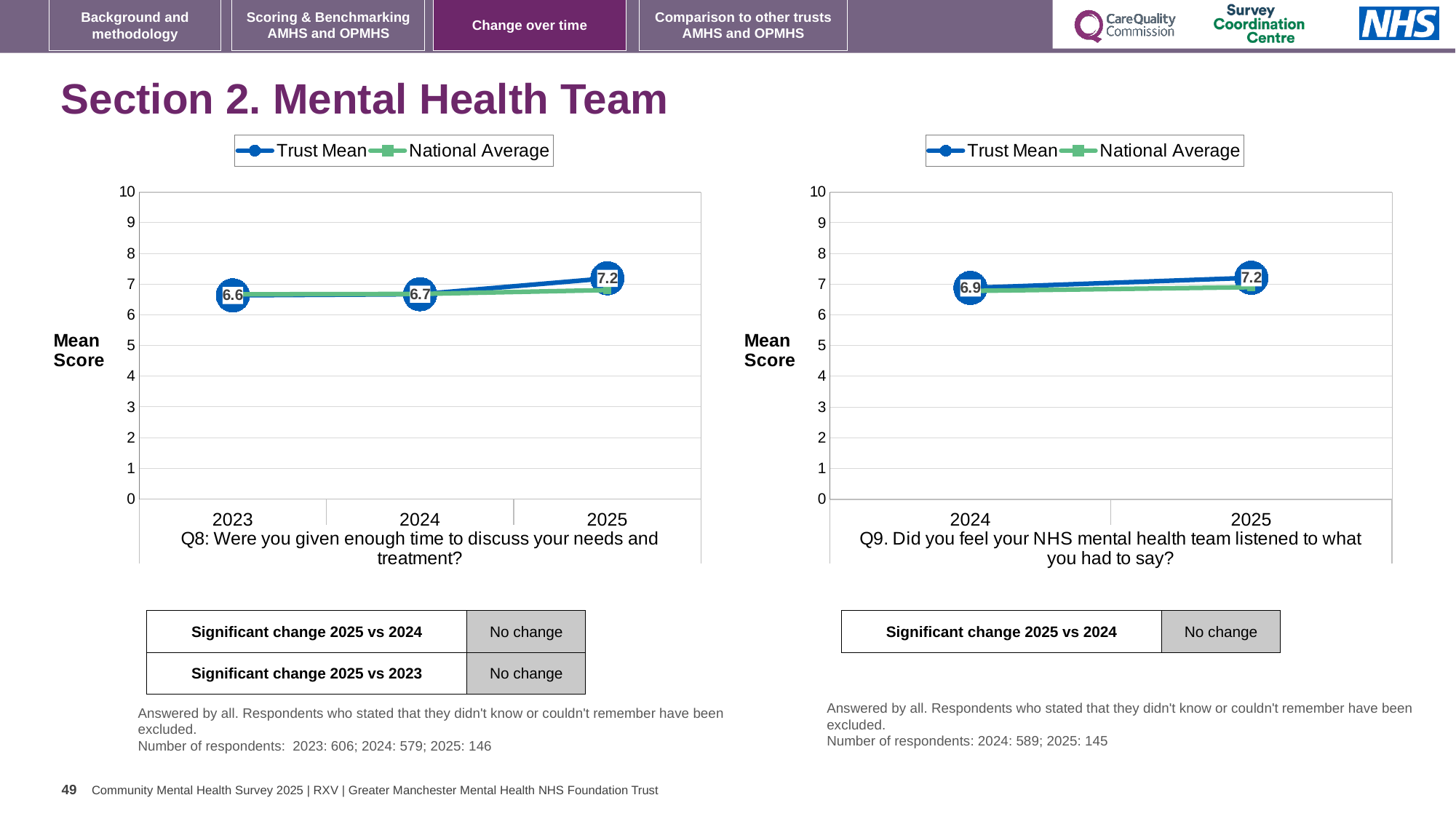
In the Q8 chart on the left, which year has the lowest Trust Mean? 2023 In the Q8 chart on the left, what is the Trust Mean for 2023? 6.6 In the Q8 chart on the left, what is the Trust Mean for 2025? 7.2 In the Q8 chart on the left, which year has the highest Trust Mean? 2025 In the Q9 chart on the right, what is the difference between the Trust Mean in 2025 and 2024? 0.3 How many years are shown on the x axis of the Q9 chart on the right? 2 In the Q8 chart on the left, is the Trust Mean higher in 2025 or in 2023? 2025 In the Q8 chart on the left, by how much did the Trust Mean change from 2024 to 2025? 0.5 How many series does the legend of the Q8 chart on the left list? 2 In the Q8 chart on the left, is the National Average for 2023 greater or less than 7? less In the Q9 chart on the right, what is the Trust Mean for 2024? 6.9 In the Q9 chart on the right, what is the Trust Mean for 2025? 7.2